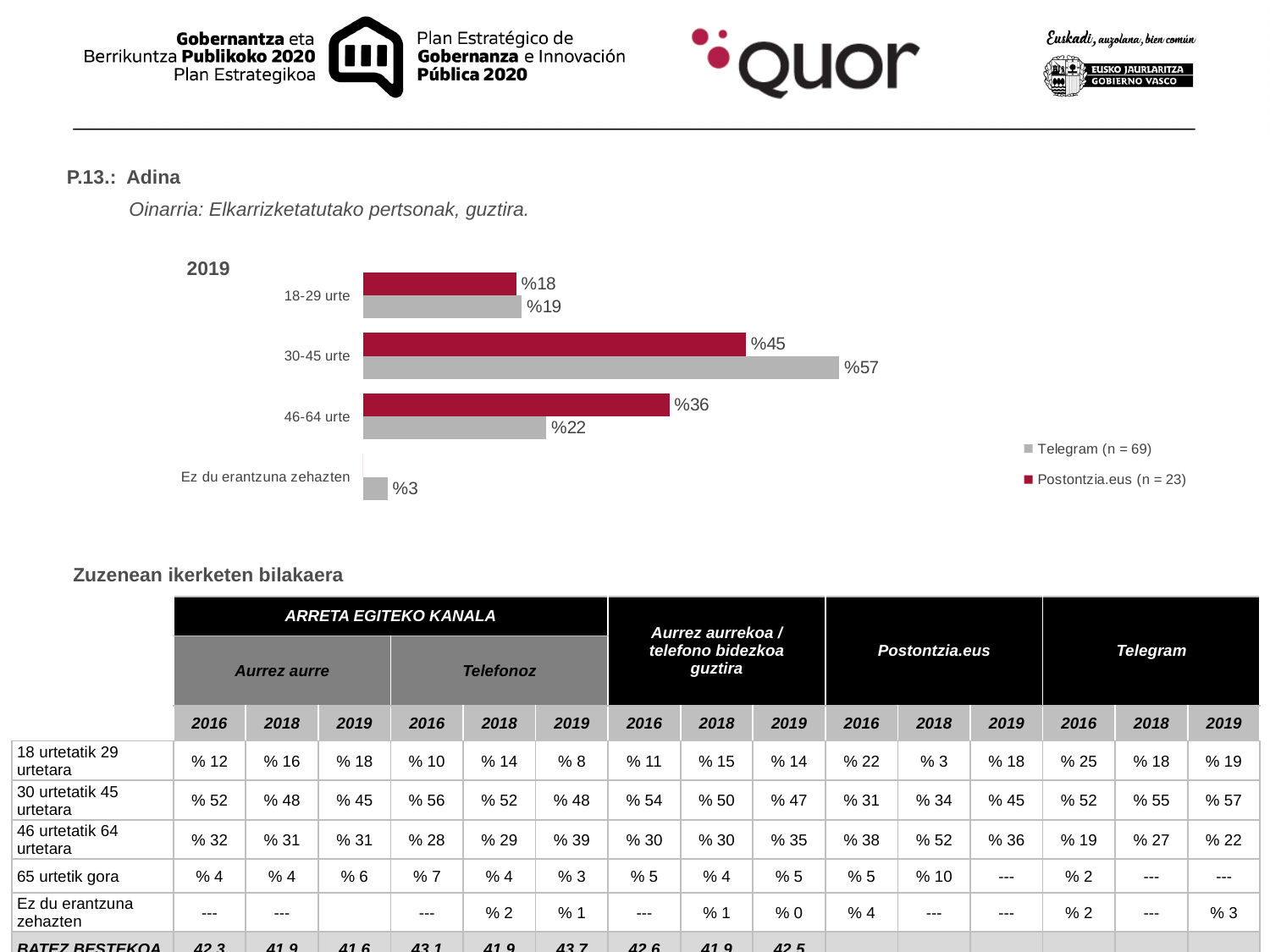
What type of chart is shown on the slide? Bar chart What is the Postontzia.eus value for the 46-64 urte category? %36 What sample size (n) does the legend give for Telegram? 69 How many categories are shown on the chart? 4 What is the difference between the Telegram and Postontzia.eus values for the 30-45 urte category? %12 Which age category has the lowest Postontzia.eus value among the three age groups? 18-29 urte For the 46-64 urte category, which series has the larger value, Telegram or Postontzia.eus? Postontzia.eus What is the Postontzia.eus value for the 18-29 urte category? %18 Which age category has the highest Telegram value? 30-45 urte What is the Telegram value for the 30-45 urte category? %57 What is the Telegram value for the Ez du erantzuna zehazten category? %3 How many series does the chart legend list? 2